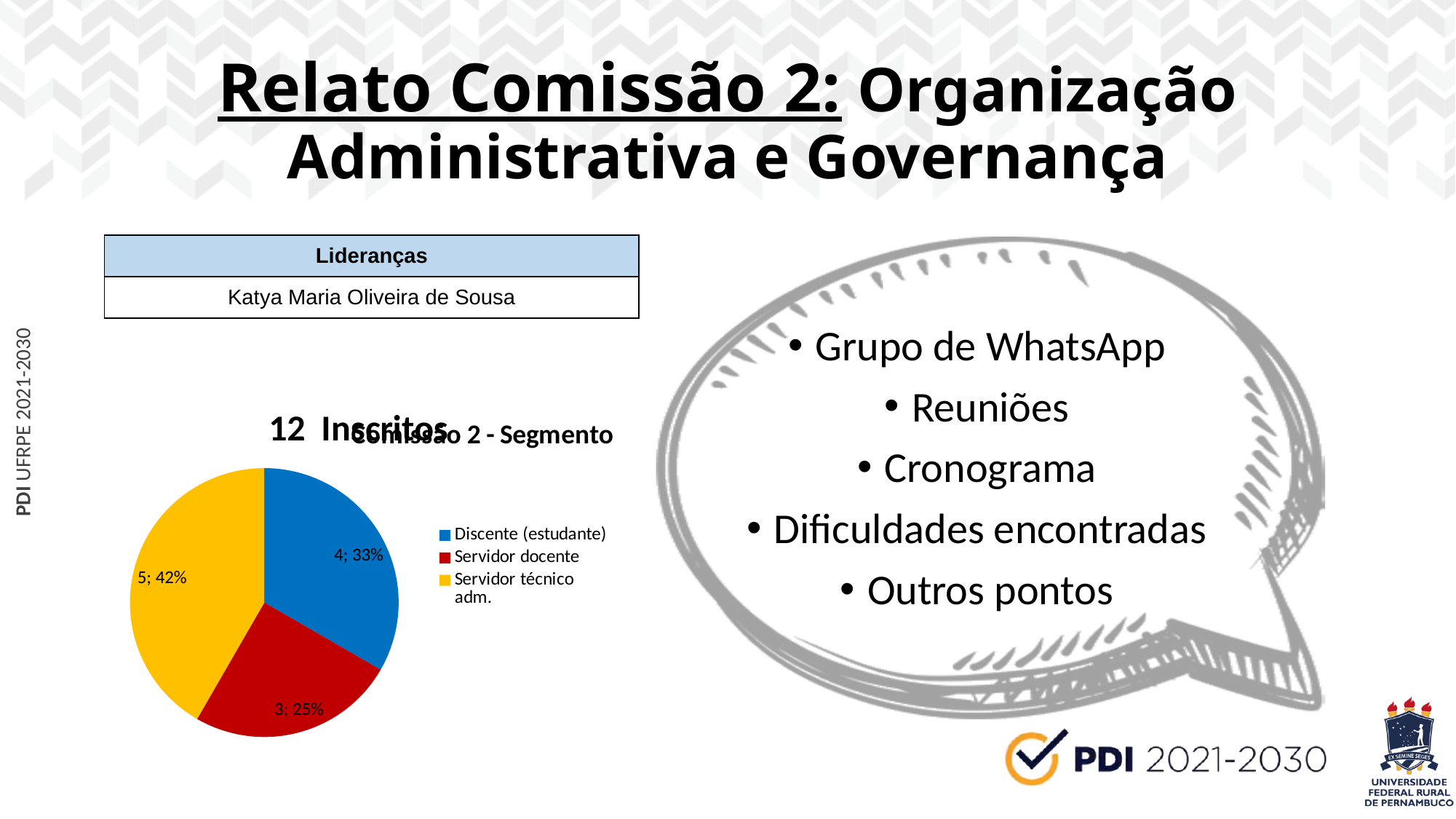
What is the value shown for Servidor técnico adm. in the pie chart? 5 What kind of chart is shown on the slide? pie chart Which segment has the largest slice in the pie chart? Servidor técnico adm. What percentage share of the pie does Servidor técnico adm. have? 42% Which colour represents Servidor docente in the pie chart? red How many slices does the pie chart have? 3 What is the value shown for Servidor docente in the pie chart? 3 What percentage share of the pie does Discente (estudante) have? 33% What is the value shown for Discente (estudante) in the pie chart? 4 Which segment has the smallest slice in the pie chart? Servidor docente What is the difference between the values for Servidor técnico adm. and Servidor docente? 2 How many entries does the legend of the pie chart list? 3